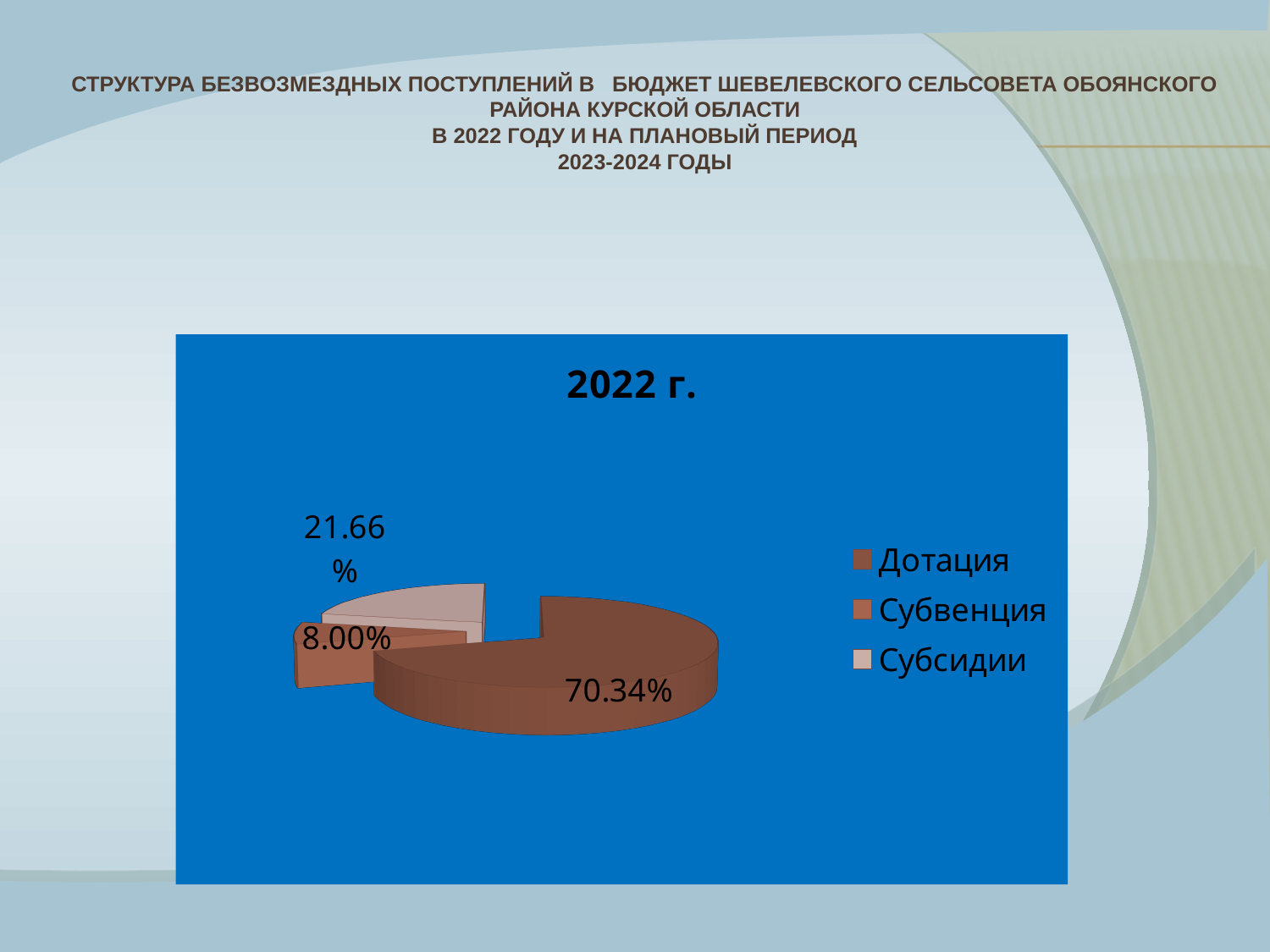
What share of the pie does Субвенция have? 8.00% How many slices does the pie chart have? 3 What is the chart's title? 2022 г. What share of the pie does Субсидии have? 21.66% Which category has the largest slice? Дотация What kind of chart is shown on the slide? pie chart Which is larger, the share for Субсидии or the share for Субвенция? Субсидии Which legend entry is shown in the lightest colour? Субсидии What is the difference between the shares of Дотация and Субсидии? 48.68% Which category has the smallest slice? Субвенция What share of the pie does Дотация have? 70.34% How many entries does the legend list? 3